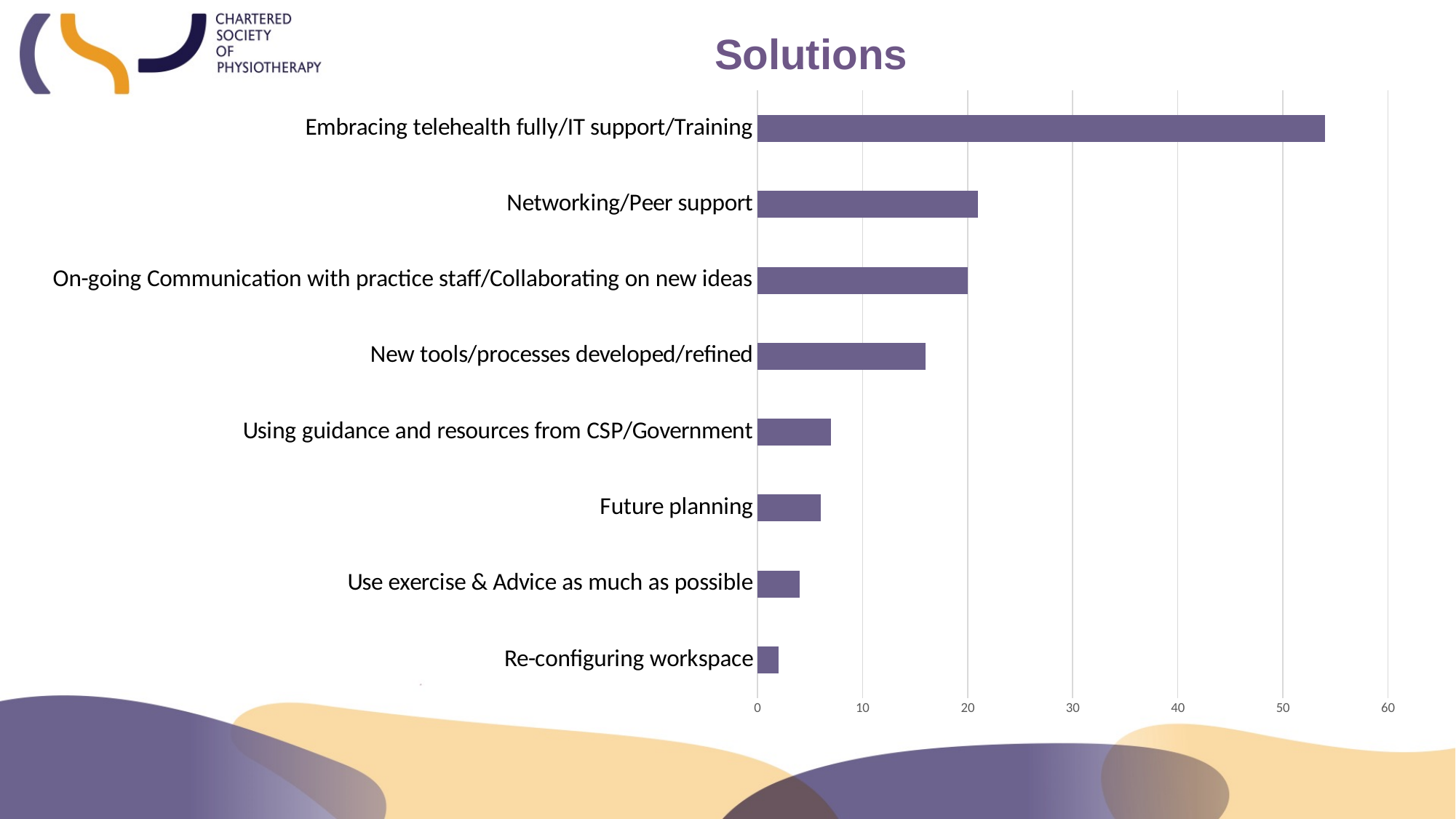
Is the value for New tools/processes developed/refined greater or less than 10? greater Is the value for Networking/Peer support greater or less than 30? less Is the value for Using guidance and resources from CSP/Government greater or less than 10? less What is the title of the chart? Solutions Which has the larger value: New tools/processes developed/refined or Future planning? New tools/processes developed/refined Which category has the lowest value? Re-configuring workspace What is the highest value shown on the horizontal axis? 60 How many categories are plotted in the chart? 8 Which has the larger value: Embracing telehealth fully/IT support/Training or Networking/Peer support? Embracing telehealth fully/IT support/Training Which category has the highest value? Embracing telehealth fully/IT support/Training What kind of chart is shown on the slide? bar chart